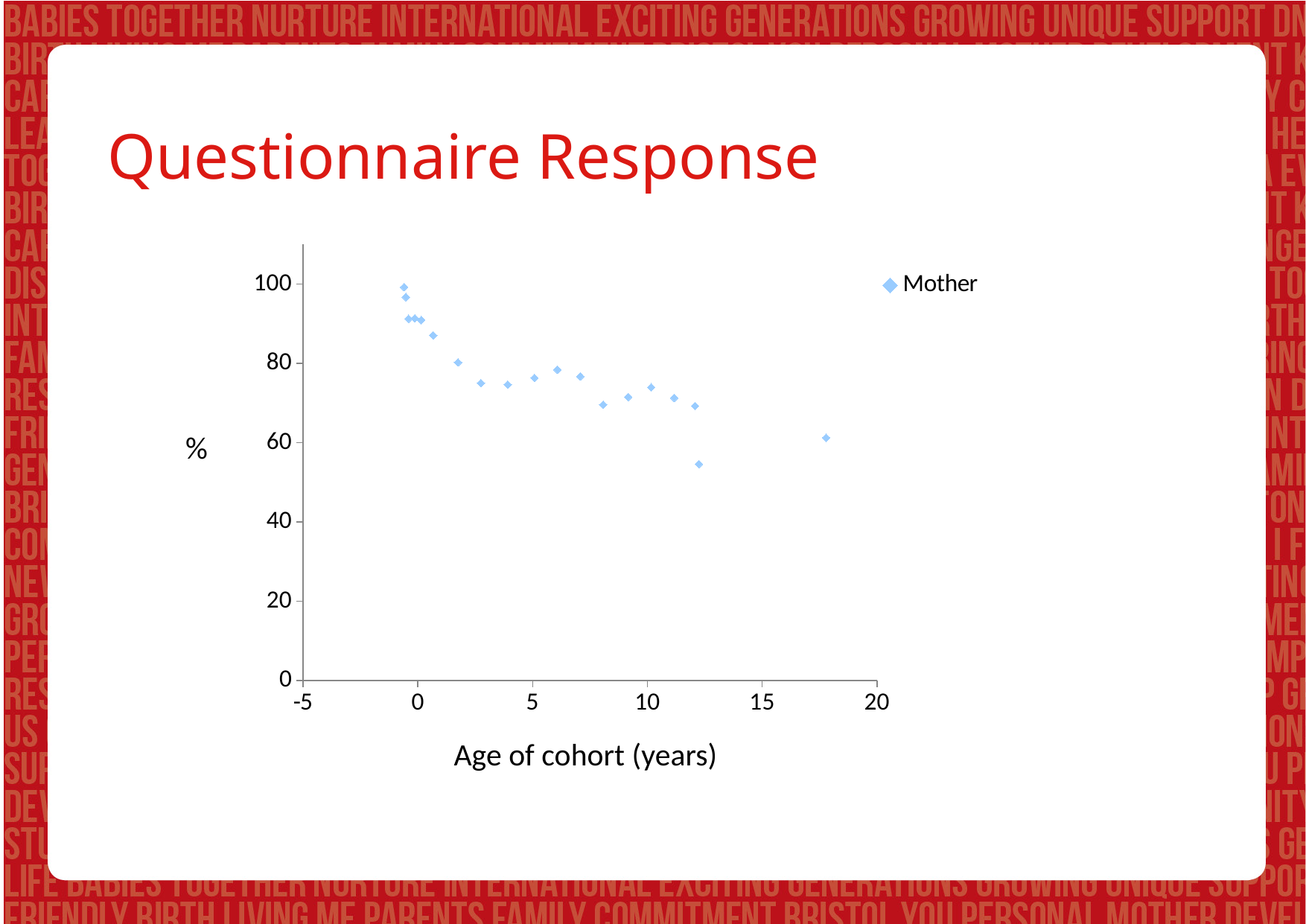
Is the value for the point at about 18 years larger or smaller than the values for the points near 0 years? smaller Do the values generally rise or fall as the age of cohort increases? fall Is the value for the point at about 5 years greater or less than 60? greater Are all the plotted values greater or less than 40? greater What kind of chart is shown on the slide? scatter chart What is the name of the series shown in the legend? Mother What is the title of the x axis? Age of cohort (years) Is the lowest plotted value greater or less than 60? less How many series does the legend list? 1